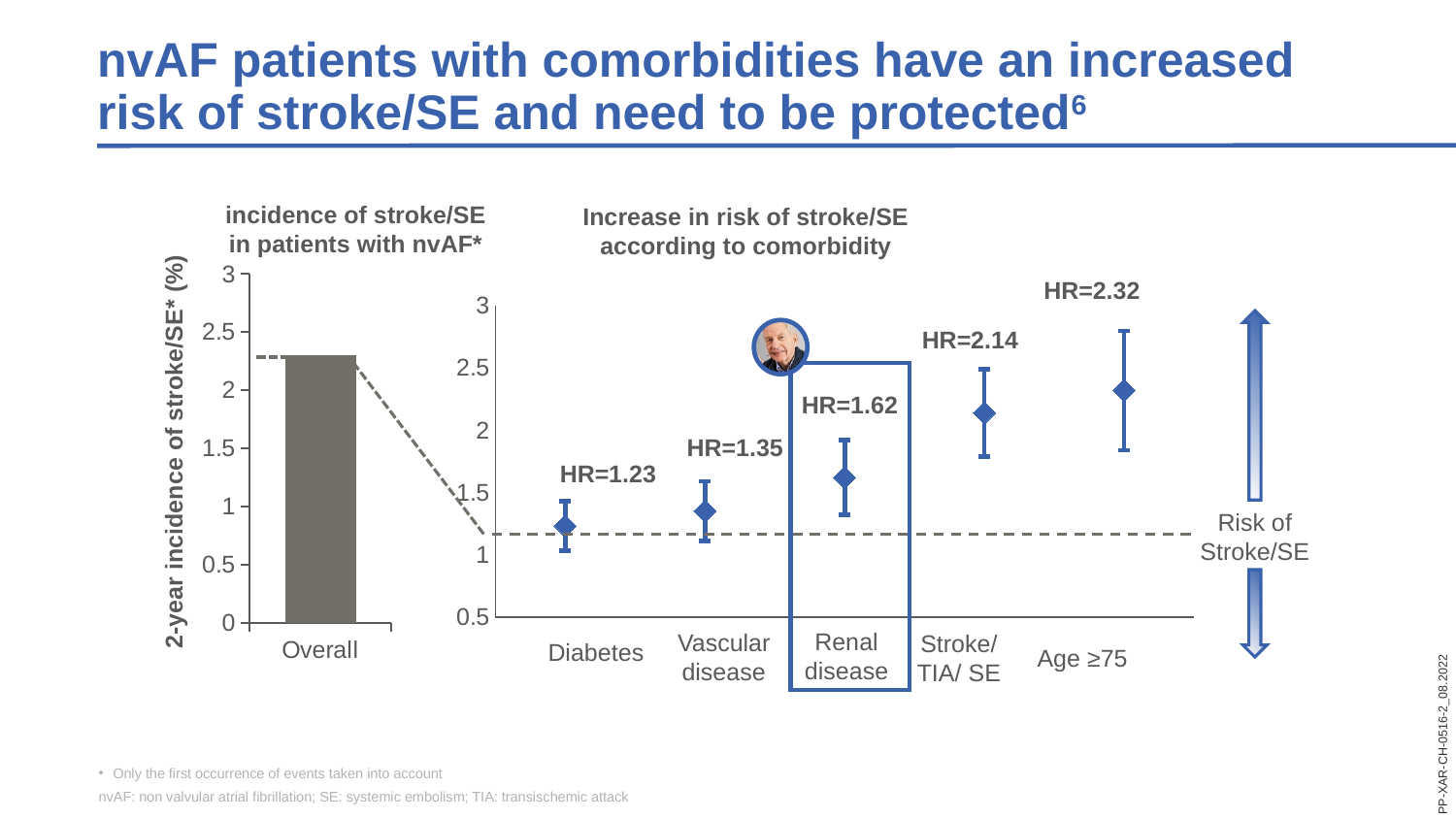
In the chart 'Increase in risk of stroke/SE according to comorbidity', which comorbidity has the highest hazard ratio? Age ≥75 In the chart 'Increase in risk of stroke/SE according to comorbidity', what is the hazard ratio for Age ≥75? HR=2.32 In the chart 'Increase in risk of stroke/SE according to comorbidity', which comorbidity has the lowest hazard ratio? Diabetes In the left chart 'incidence of stroke/SE in patients with nvAF*', is the value for Overall greater or less than 2? greater In the chart 'Increase in risk of stroke/SE according to comorbidity', what is the difference between the hazard ratios for Age ≥75 and Diabetes? 1.09 In the chart 'Increase in risk of stroke/SE according to comorbidity', what is the hazard ratio for Renal disease? HR=1.62 What kind of chart is the left chart 'incidence of stroke/SE in patients with nvAF*'? bar chart How many comorbidity categories are shown in the chart 'Increase in risk of stroke/SE according to comorbidity'? 5 In the chart 'Increase in risk of stroke/SE according to comorbidity', which has a larger hazard ratio, Vascular disease or Renal disease? Renal disease In the chart 'Increase in risk of stroke/SE according to comorbidity', what is the difference between the hazard ratios for Stroke/TIA/SE and Renal disease? 0.52 In the chart 'Increase in risk of stroke/SE according to comorbidity', what is the hazard ratio for Diabetes? HR=1.23 In the chart 'Increase in risk of stroke/SE according to comorbidity', do the hazard ratios rise or fall from left to right? rise